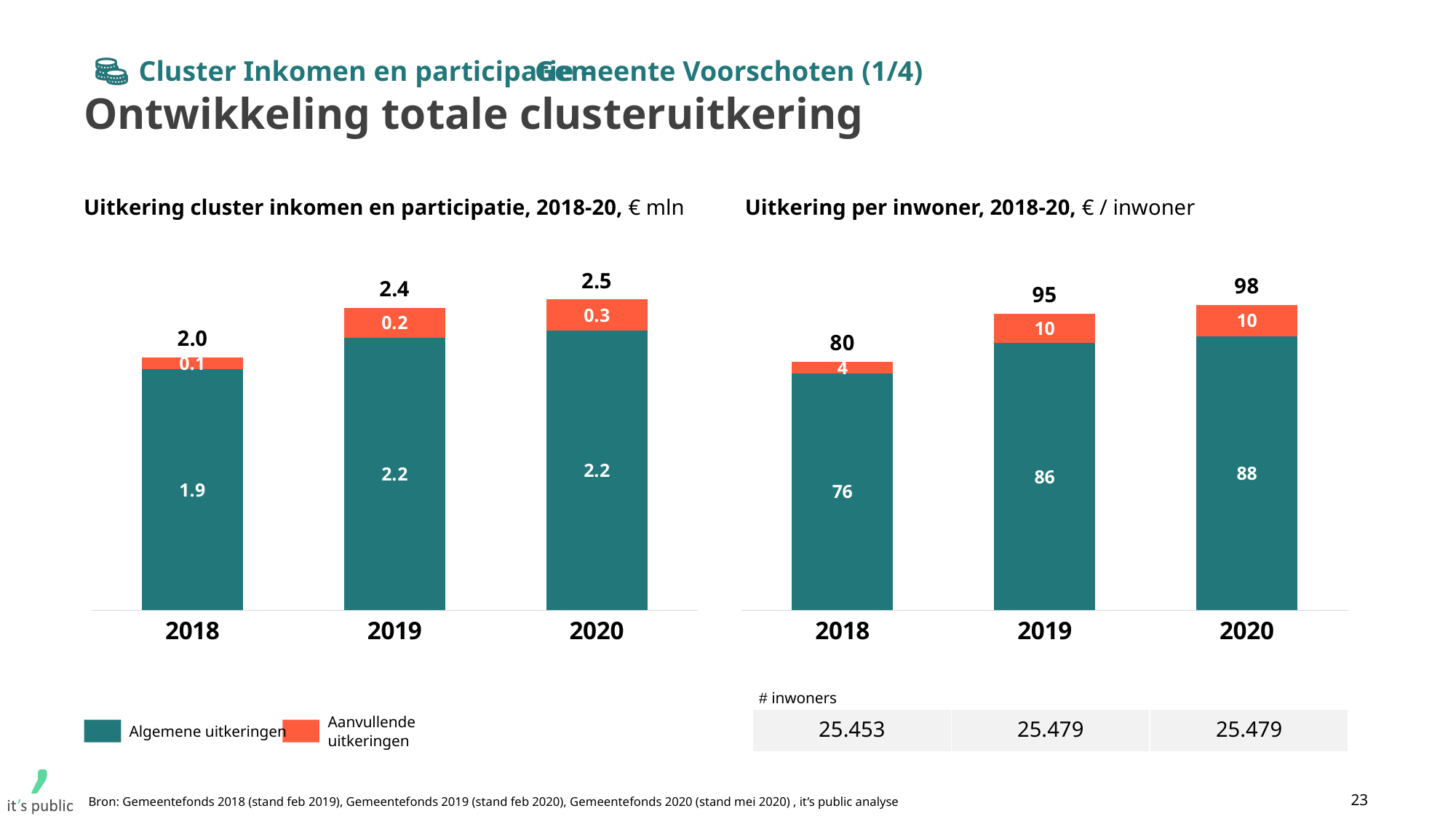
In the right chart (Uitkering per inwoner), what is the difference between the Algemene uitkeringen values for 2020 and 2018? 12 In the right chart (Uitkering per inwoner), which year has the highest total? 2020 In the left chart (Uitkering cluster inkomen en participatie), which year has the lowest total? 2018 In the right chart (Uitkering per inwoner), what is the value of Algemene uitkeringen for 2019? 86 What kind of chart is the left chart (Uitkering cluster inkomen en participatie)? Stacked bar chart In the right chart (Uitkering per inwoner), what is the total for 2018? 80 How many series does the legend list? 2 How many years are shown on the x axis of the right chart (Uitkering per inwoner)? 3 In the left chart (Uitkering cluster inkomen en participatie), what is the value of Aanvullende uitkeringen for 2019? 0.2 In the left chart (Uitkering cluster inkomen en participatie), what is the value of Algemene uitkeringen for 2018? 1.9 In the left chart (Uitkering cluster inkomen en participatie), what is the total for 2020? 2.5 In the left chart (Uitkering cluster inkomen en participatie), is the Aanvullende uitkeringen value larger in 2020 or in 2018? 2020